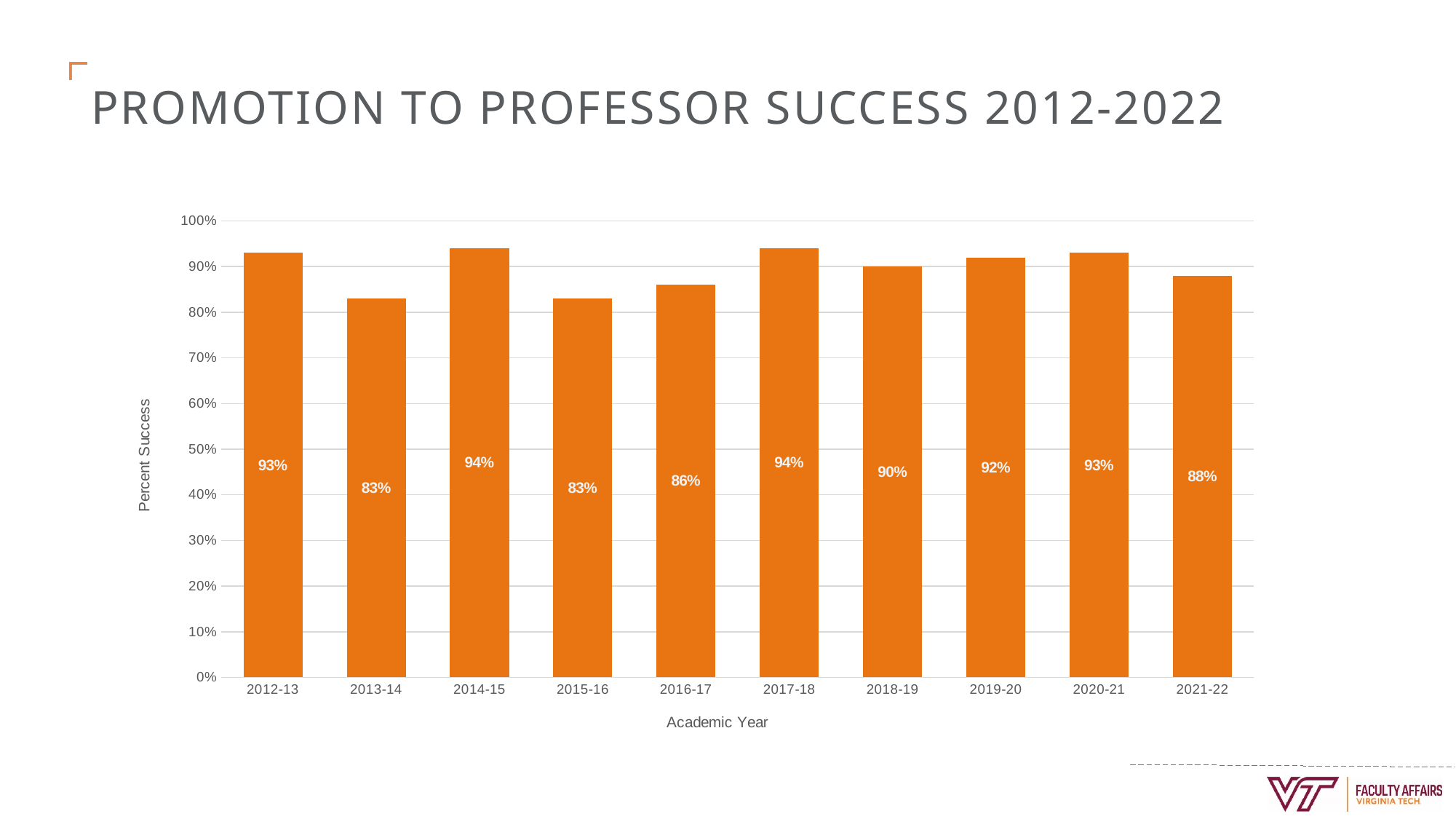
What is the percent success for 2016-17? 86% Which two academic years share the lowest percent success? 2013-14 and 2015-16 How many academic years are shown on the x axis? 10 What kind of chart is shown on the slide? Bar chart What is the percent success for 2012-13? 93% Which academic year has a higher percent success, 2019-20 or 2021-22? 2019-20 What is the percent success for 2018-19? 90% What is the percent success for 2021-22? 88% Which two academic years share the highest percent success? 2014-15 and 2017-18 Is the value for 2013-14 greater or less than 90%? less What is the difference in percent success between 2014-15 and 2015-16? 11% What is the label of the y axis? Percent Success